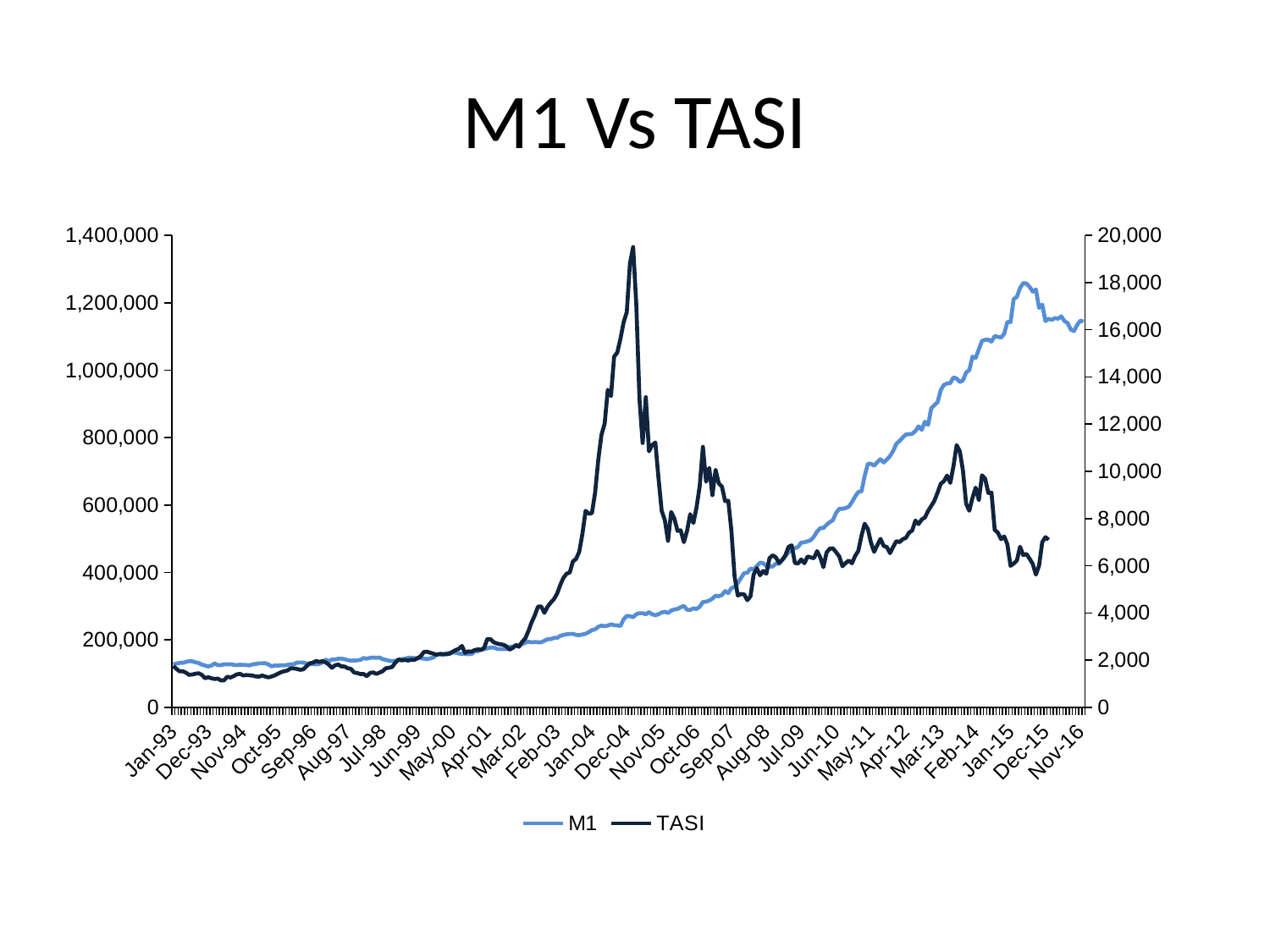
How many series does the legend list? 2 Is the value of TASI at Dec-15 greater or less than 8,000? less Is the peak value of TASI around Dec-04 greater or less than 16,000? greater Is the value of M1 at Jan-93 greater or less than 200,000? less What is the title of the chart? M1 Vs TASI Which series is drawn in the lighter blue line? M1 Does the TASI series rise or fall between Dec-04 and Nov-05? fall Does the M1 series generally rise or fall from Jan-93 to Nov-16? rise What kind of chart is shown on the slide? line chart